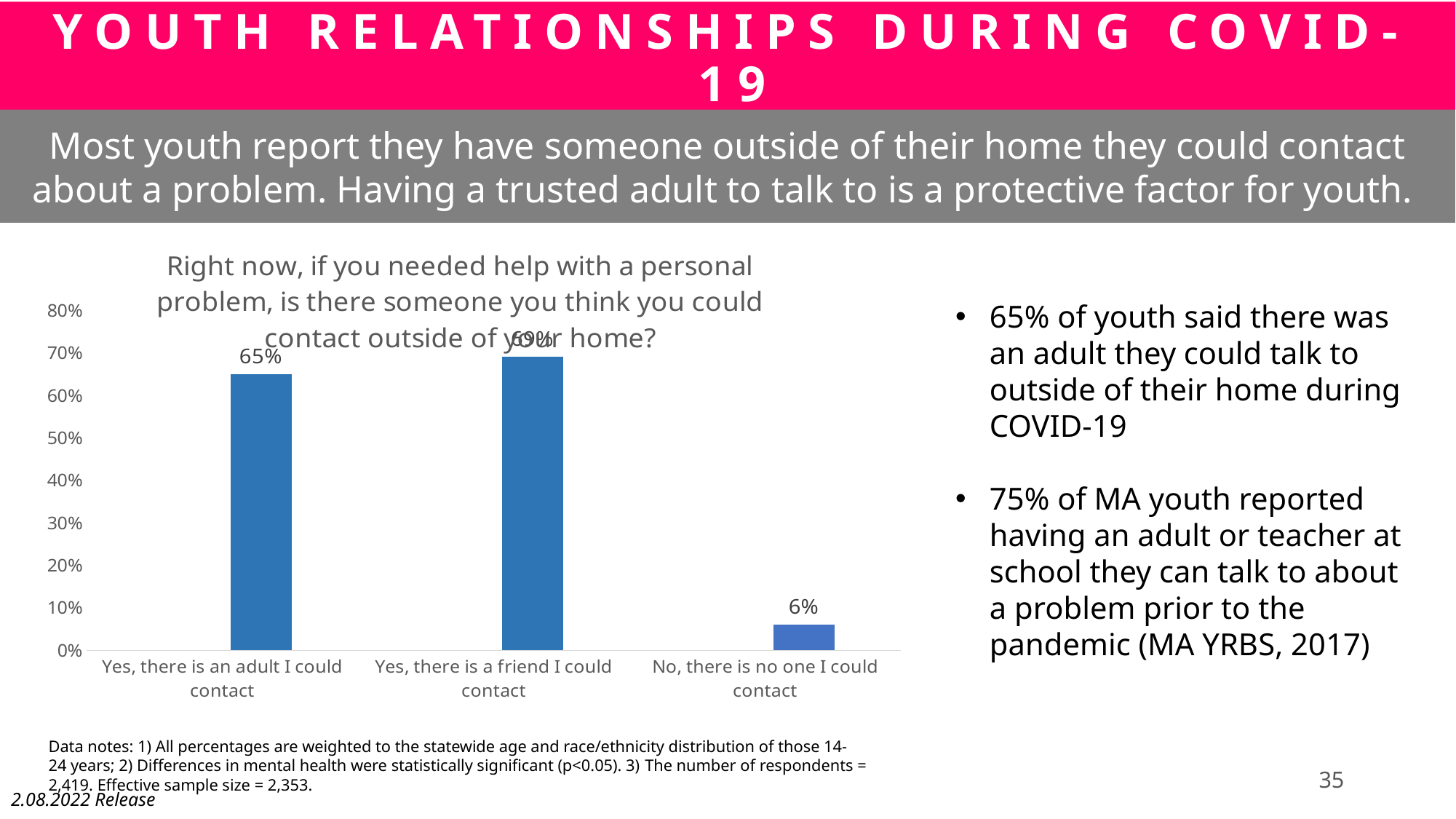
What percentage of youth said there is an adult they could contact outside their home? 65% Which is larger: the share saying there is an adult they could contact, or the share saying there is a friend they could contact? Yes, there is a friend I could contact What type of chart is shown on the slide? Bar chart What percentage of youth said there is no one they could contact? 6% What is the difference in percentage points between the adult-contact bar and the no-one bar? 59 percentage points Is the value for 'Yes, there is a friend I could contact' greater or less than 60%? greater Is the value for 'No, there is no one I could contact' greater or less than 10%? less Which response category has the lowest value in the chart? No, there is no one I could contact Which response category has the highest value in the chart? Yes, there is a friend I could contact What is the highest value shown on the chart's vertical axis? 80% How many response categories are shown in the chart? 3 What percentage of youth said there is a friend they could contact? 69%